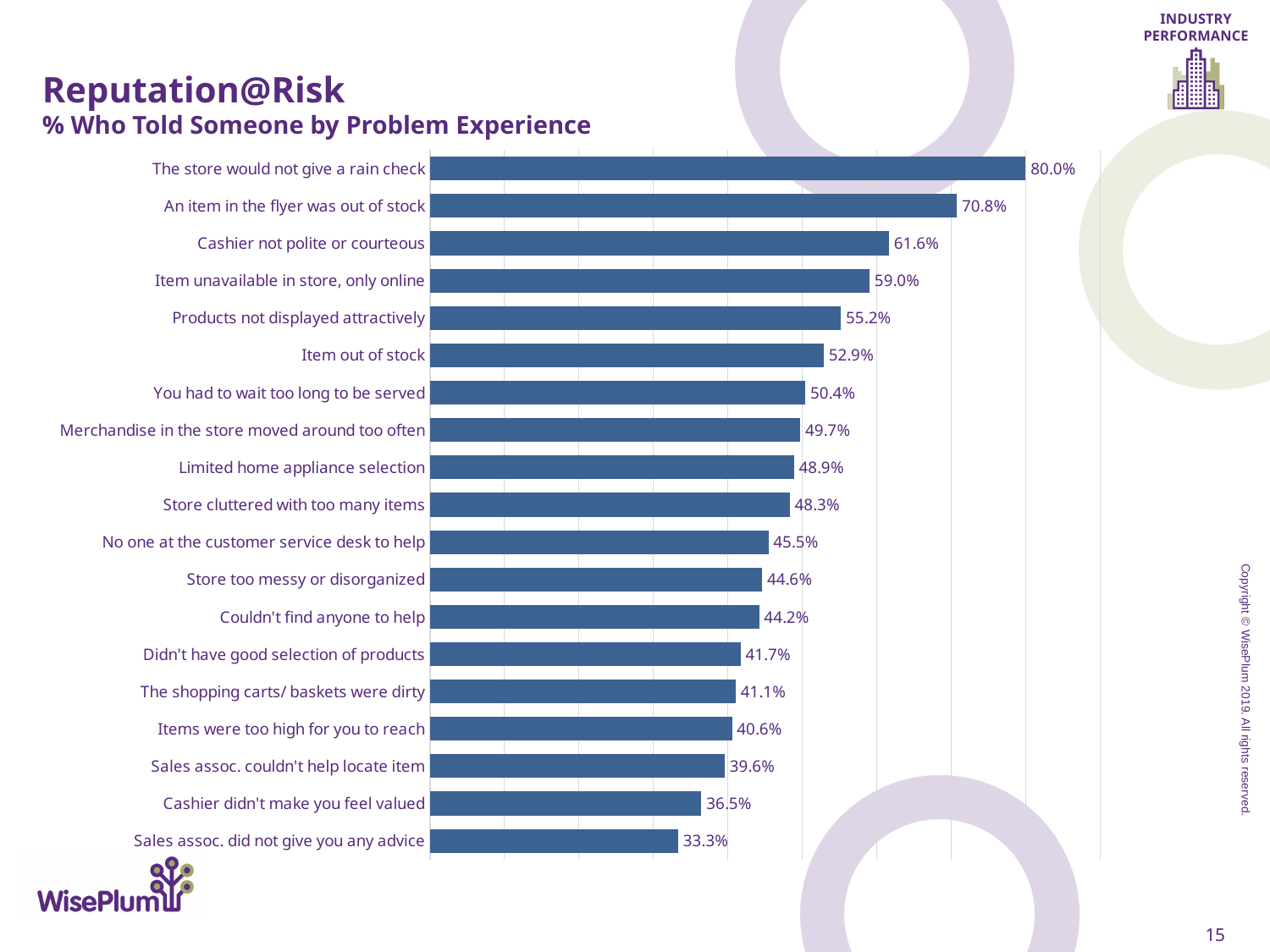
What is the difference between the highest and lowest values in the chart? 46.7% What is the subtitle of the chart on the slide? % Who Told Someone by Problem Experience What percentage is shown for "Cashier didn't make you feel valued"? 36.5% What is the value for "Limited home appliance selection"? 48.9% Which problem experience has the lowest percentage? Sales assoc. did not give you any advice Which is larger: the value for "Products not displayed attractively" or "You had to wait too long to be served"? Products not displayed attractively Which problem experience has the highest percentage of people who told someone? The store would not give a rain check What type of chart is shown on the slide? Bar chart How many problem experiences are plotted in the chart? 19 What is the difference between "An item in the flyer was out of stock" and "Cashier not polite or courteous"? 9.2% What percentage told someone about the problem "The store would not give a rain check"? 80.0% What is the value for "Item out of stock"? 52.9%